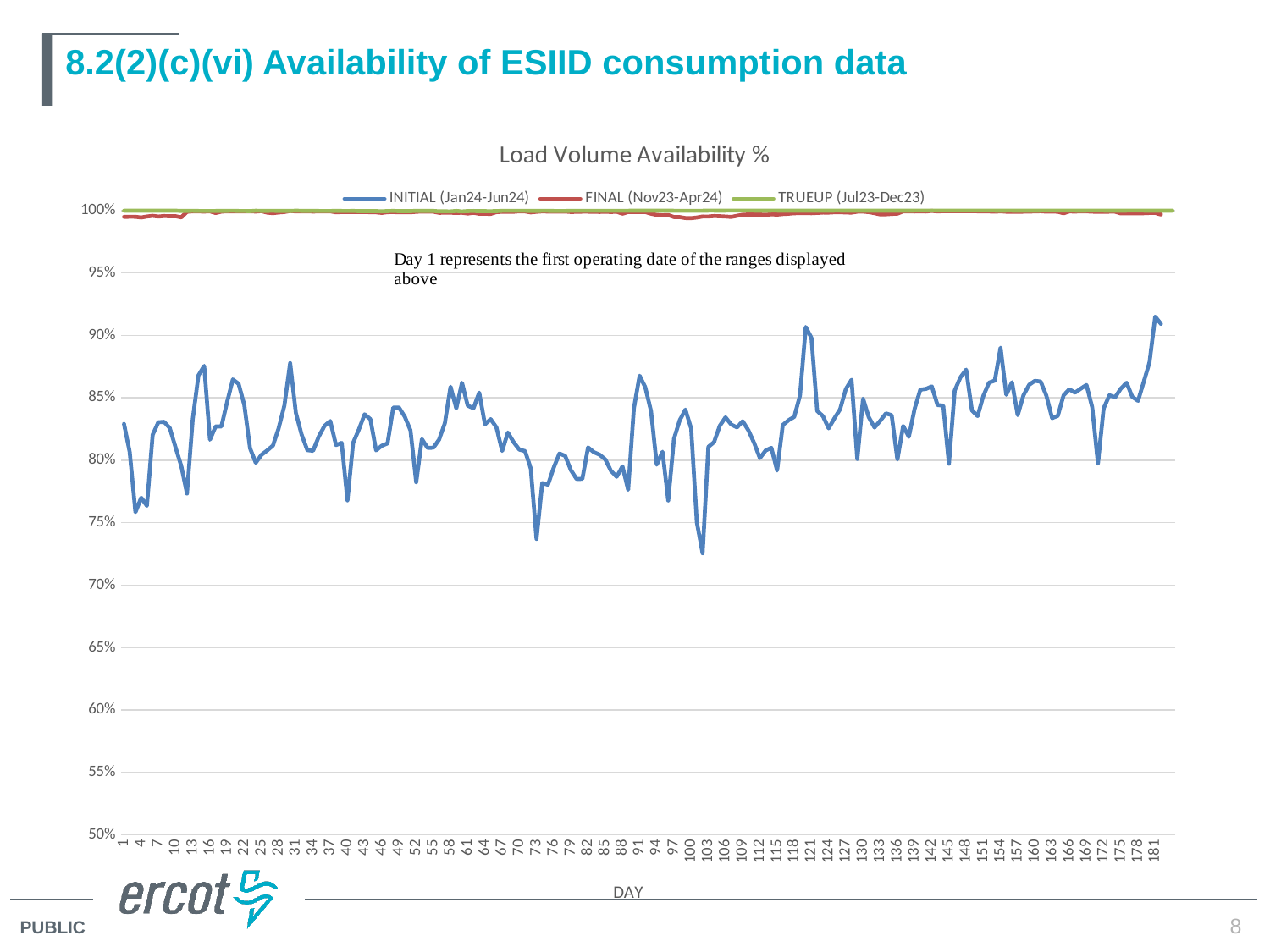
Is the value of the FINAL (Nov23-Apr24) series at day 100 greater or less than 95%? greater Which series has the highest values across the chart? TRUEUP (Jul23-Dec23) Is the value of the INITIAL (Jan24-Jun24) series at day 181 greater or less than 90%? greater What kind of chart is shown on the slide? Line chart How many series does the legend list? 3 Is the value of the INITIAL (Jan24-Jun24) series at day 73 greater or less than 75%? less What is the last day shown on the x axis? 181 At day 121, which series is larger: INITIAL (Jan24-Jun24) or FINAL (Nov23-Apr24)? FINAL (Nov23-Apr24) What is the label of the x axis? DAY Which series has the lowest values across the chart? INITIAL (Jan24-Jun24) What is the title of the chart? Load Volume Availability %